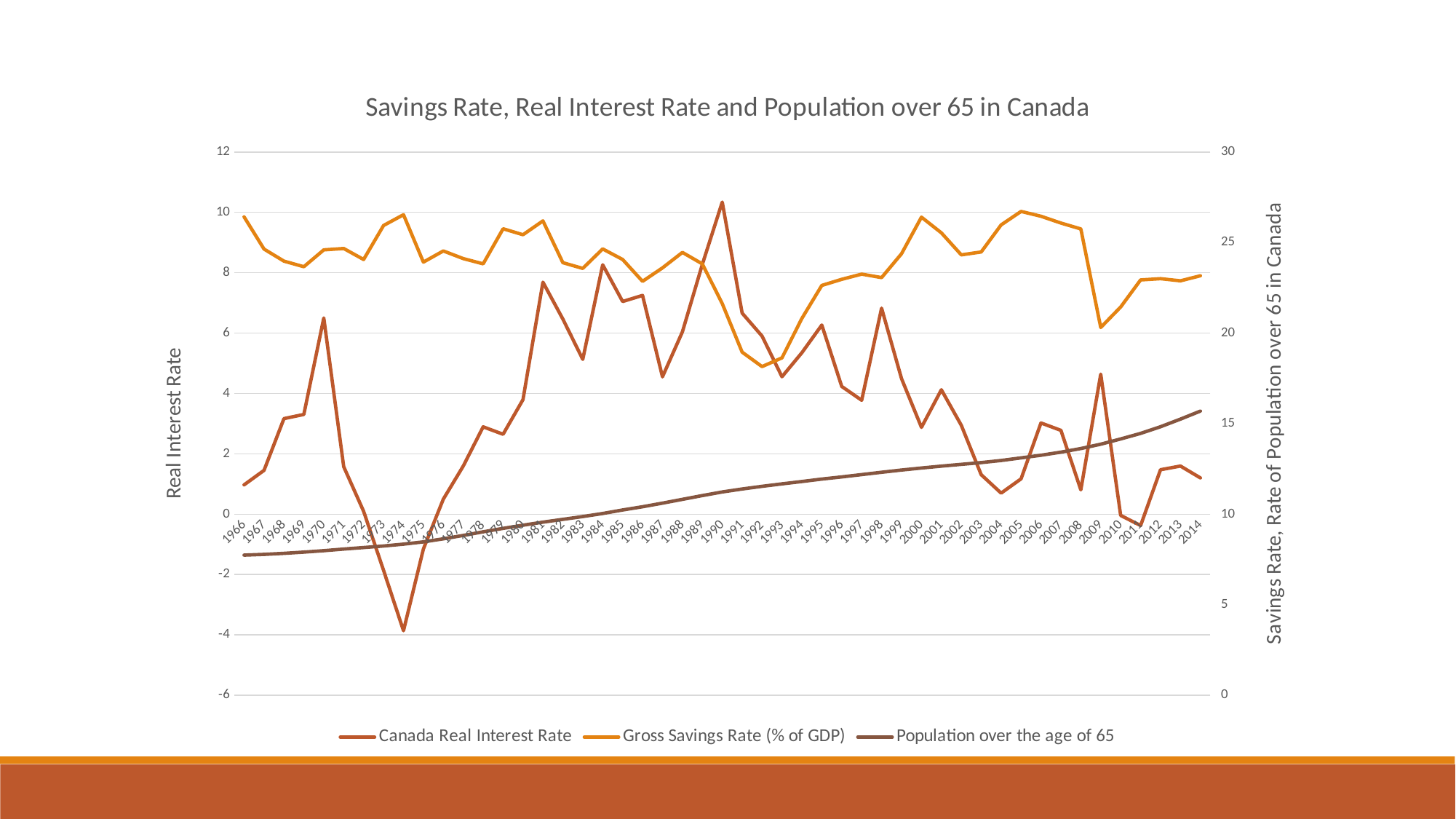
In which year is the Canada Real Interest Rate lowest? 1974 Does the Population over the age of 65 series rise or fall from 1966 to 2014? rise Which is larger, the Gross Savings Rate (% of GDP) in 1966 or in 2009? 1966 In which year is the Canada Real Interest Rate highest? 1990 What kind of chart is shown on the slide? line chart How many series does the legend list? 3 Is the Gross Savings Rate (% of GDP) in 2009 greater or less than 25? less How many years are plotted along the x axis? 49 Is the Canada Real Interest Rate in 1974 greater or less than -2? less What is the label of the left vertical axis? Real Interest Rate What is the title of the chart? Savings Rate, Real Interest Rate and Population over 65 in Canada Is the Canada Real Interest Rate in 1990 greater or less than 8? greater